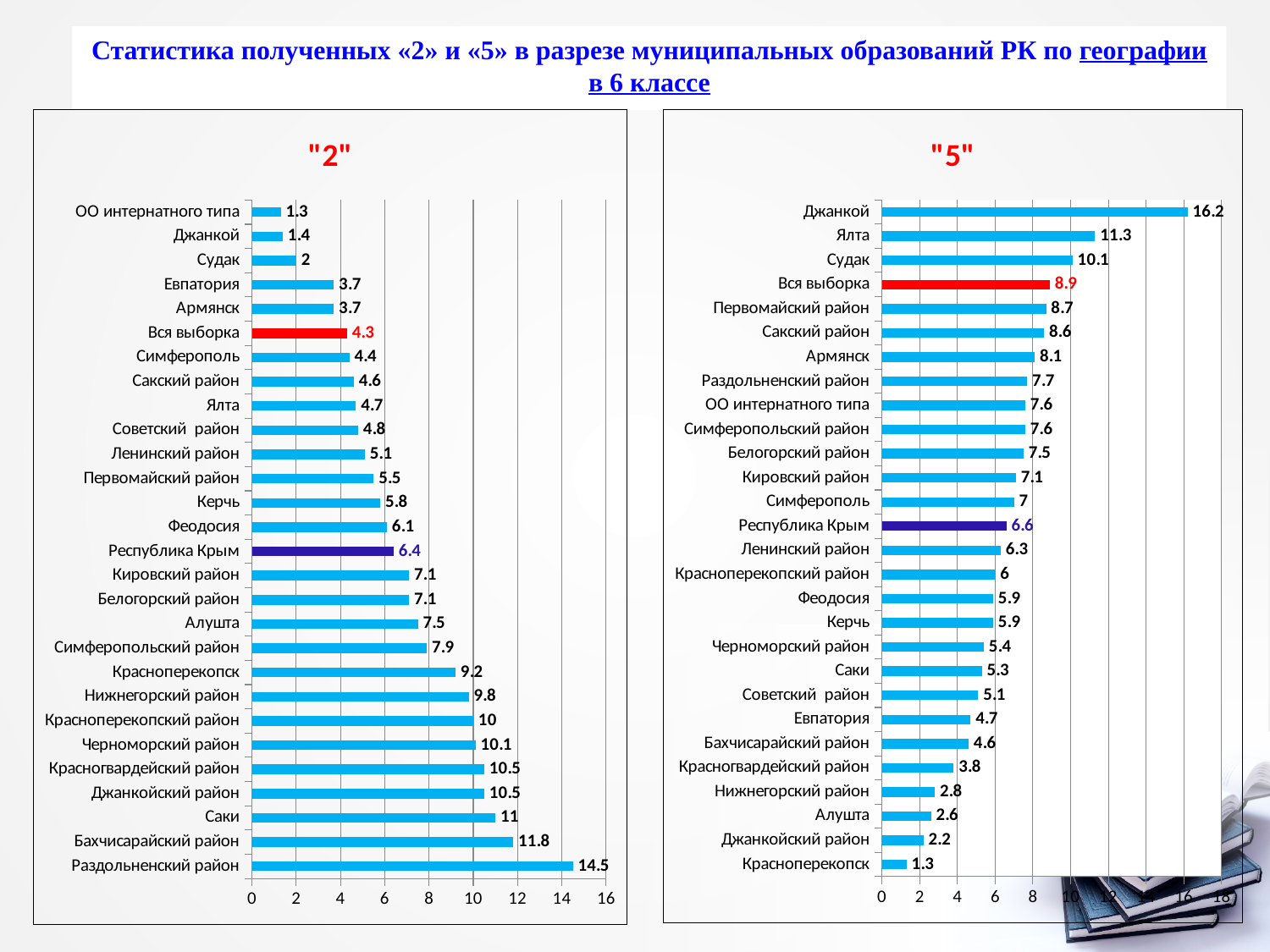
In the "5" chart, which category has the highest value? Джанкой In the "5" chart, what is the value for Джанкой? 16.2 What type of chart is the "5" chart? Bar chart How many categories are shown in the "2" chart? 28 In the "5" chart, which category has the lowest value? Красноперекопск In the "5" chart, which is larger: Ялта or Судак? Ялта In the "2" chart, what is the value for Раздольненский район? 14.5 In the "2" chart, what is the difference between Красноперекопск and Симферопольский район? 1.3 In the "5" chart, what is the value for Вся выборка? 8.9 In the "2" chart, which category has the lowest value? ОО интернатного типа In the "2" chart, what is the value for Республика Крым? 6.4 In the "2" chart, what is the difference between Бахчисарайский район and Саки? 0.8